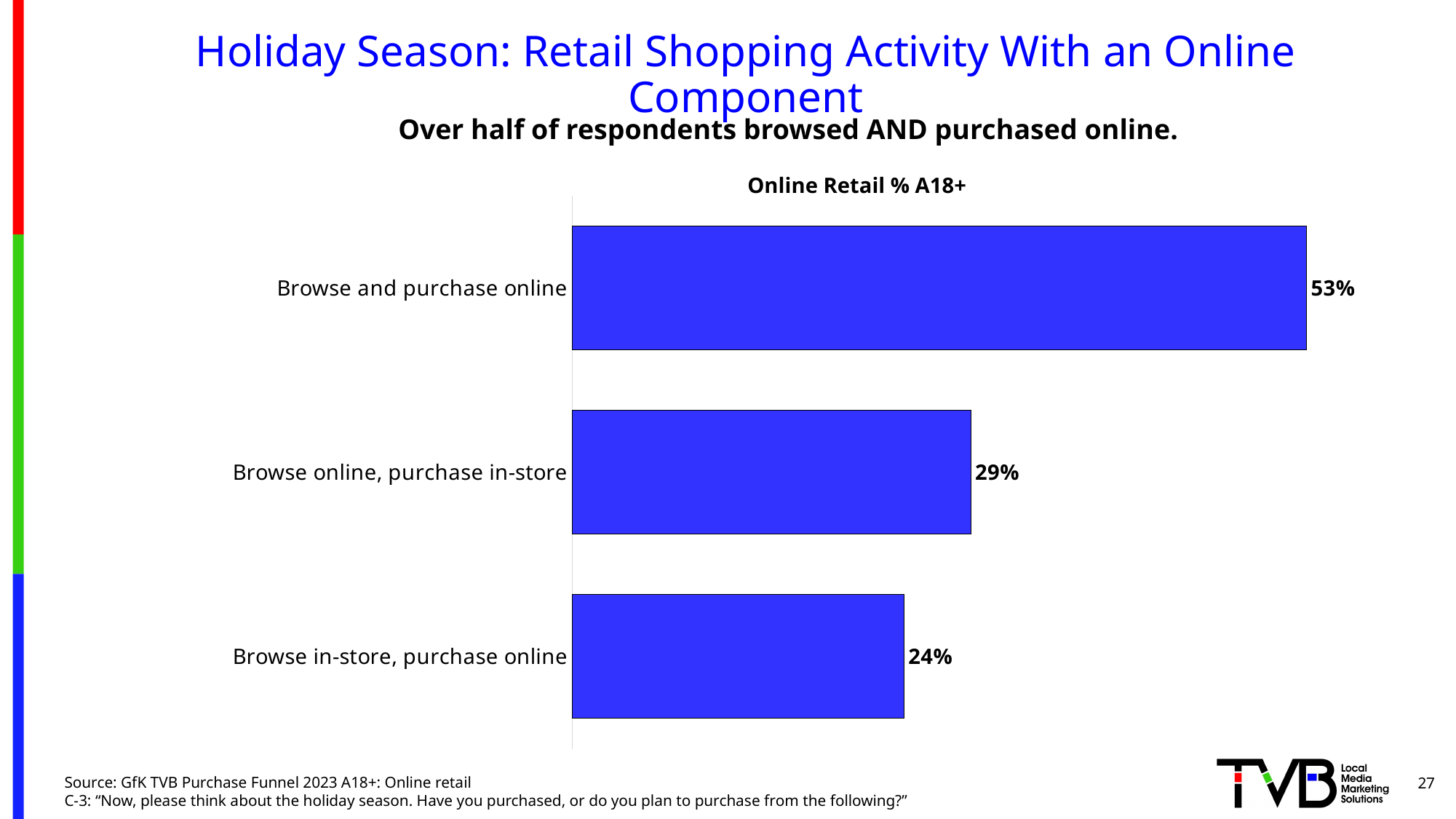
What is the value for 'Browse online, purchase in-store'? 29% Which category has the lowest value? Browse in-store, purchase online What percentage of respondents browse and purchase online? 53% Which is larger: 'Browse online, purchase in-store' or 'Browse in-store, purchase online'? Browse online, purchase in-store What is the value for 'Browse in-store, purchase online'? 24% What is the difference between 'Browse and purchase online' and 'Browse online, purchase in-store'? 24% What is the title of the chart? Online Retail % A18+ What colour are the bars in the chart? Blue What kind of chart is shown on the slide? Bar chart What is the difference between 'Browse online, purchase in-store' and 'Browse in-store, purchase online'? 5% Which category has the highest value? Browse and purchase online How many categories are shown in the chart? 3